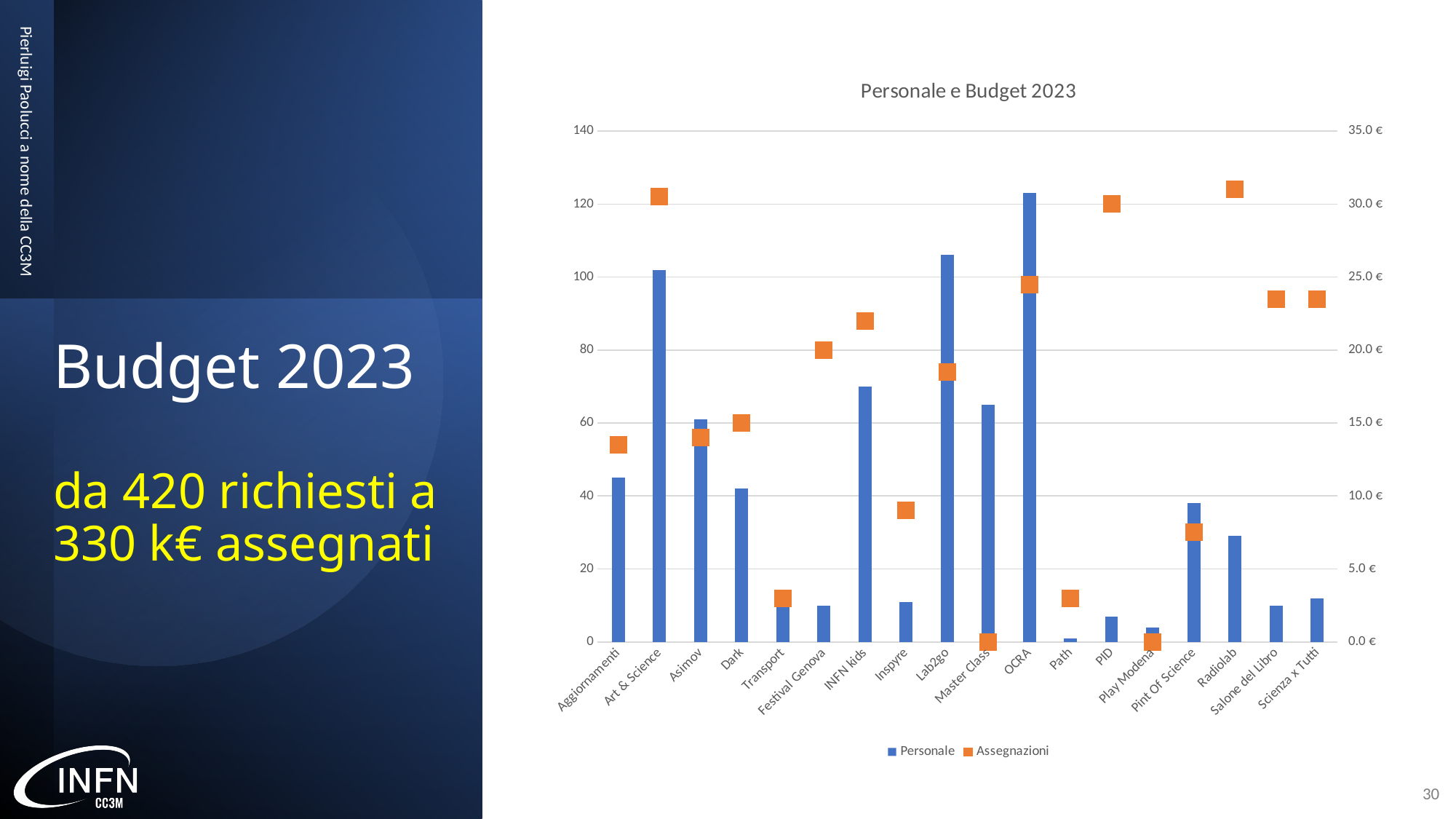
How many series does the chart legend list? 2 How many categories are shown on the x axis of the chart? 18 Which has the larger Personale value, OCRA or Lab2go? OCRA Is the Assegnazioni value for Inspyre greater or less than 10.0 €? less Is the Personale value for Radiolab greater or less than 40? less Which category has the highest Personale bar? OCRA Which category has the lowest Personale bar? Path Is the Personale value for INFN kids greater or less than 60? greater What are the two series named in the legend? Personale and Assegnazioni What is the title of the chart? Personale e Budget 2023 Which has the larger Assegnazioni value, Art & Science or Aggiornamenti? Art & Science